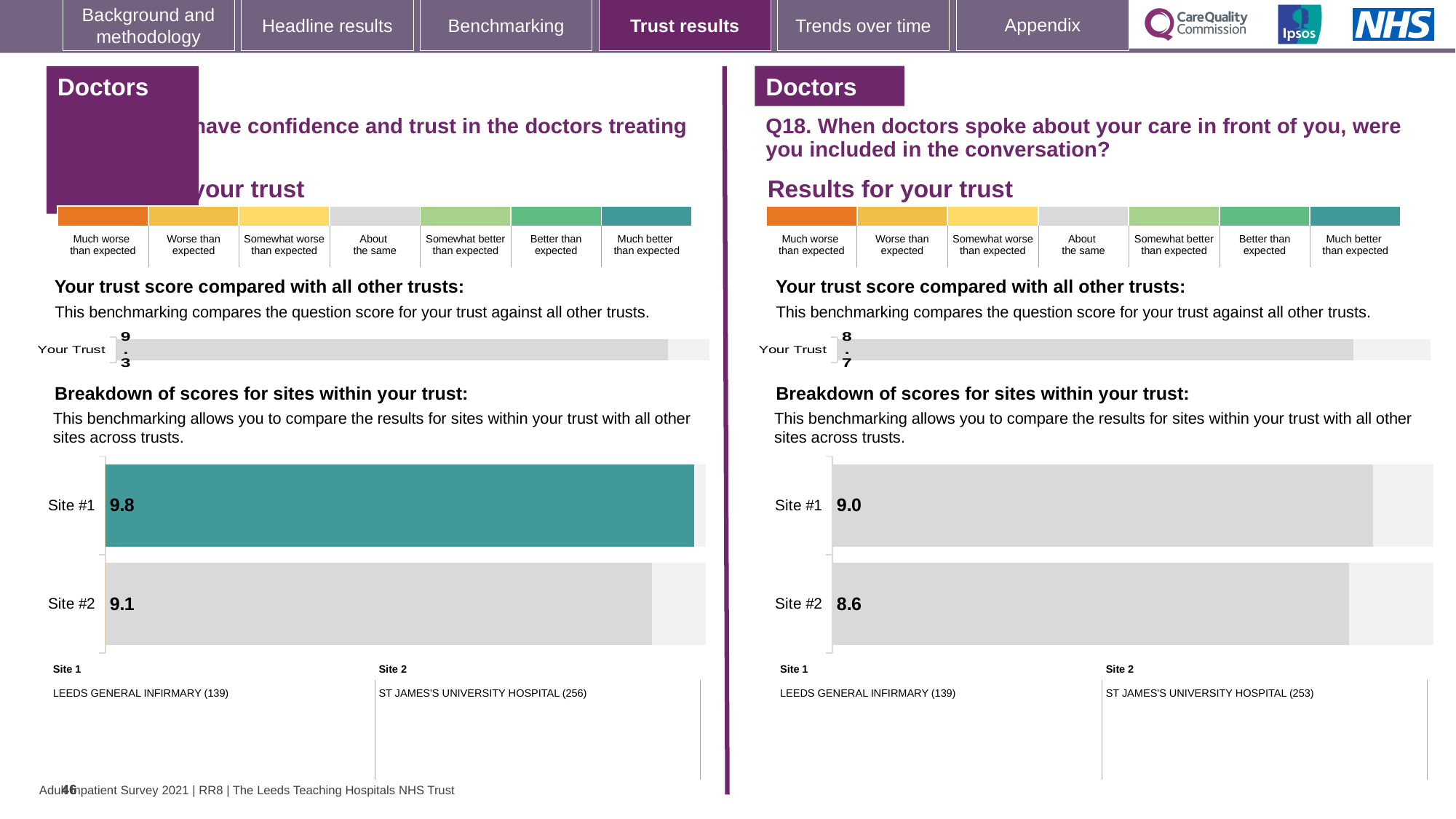
In the left-hand 'Your trust score compared with all other trusts' chart, what is the score shown for Your Trust? 9.3 In the left-hand site breakdown chart, which site has the higher score? Site #1 In the Q18 site breakdown chart on the right, what is the score for Site #2? 8.6 In the left-hand site breakdown chart, what is the difference between the Site #1 and Site #2 scores? 0.7 In the Q18 site breakdown chart on the right, which site has the lower score? Site #2 What type of chart is used for the site breakdown on the left-hand side of the slide? Bar chart In the Q18 'Your trust score compared with all other trusts' chart on the right, what is the score shown for Your Trust? 8.7 In the left-hand site breakdown chart, what is the score for Site #1? 9.8 In the left-hand site breakdown chart, what is the score for Site #2? 9.1 How many sites are shown in the Q18 site breakdown chart on the right? 2 In the Q18 site breakdown chart on the right, what is the score for Site #1? 9.0 In the Q18 site breakdown chart on the right, what is the difference between the Site #1 and Site #2 scores? 0.4